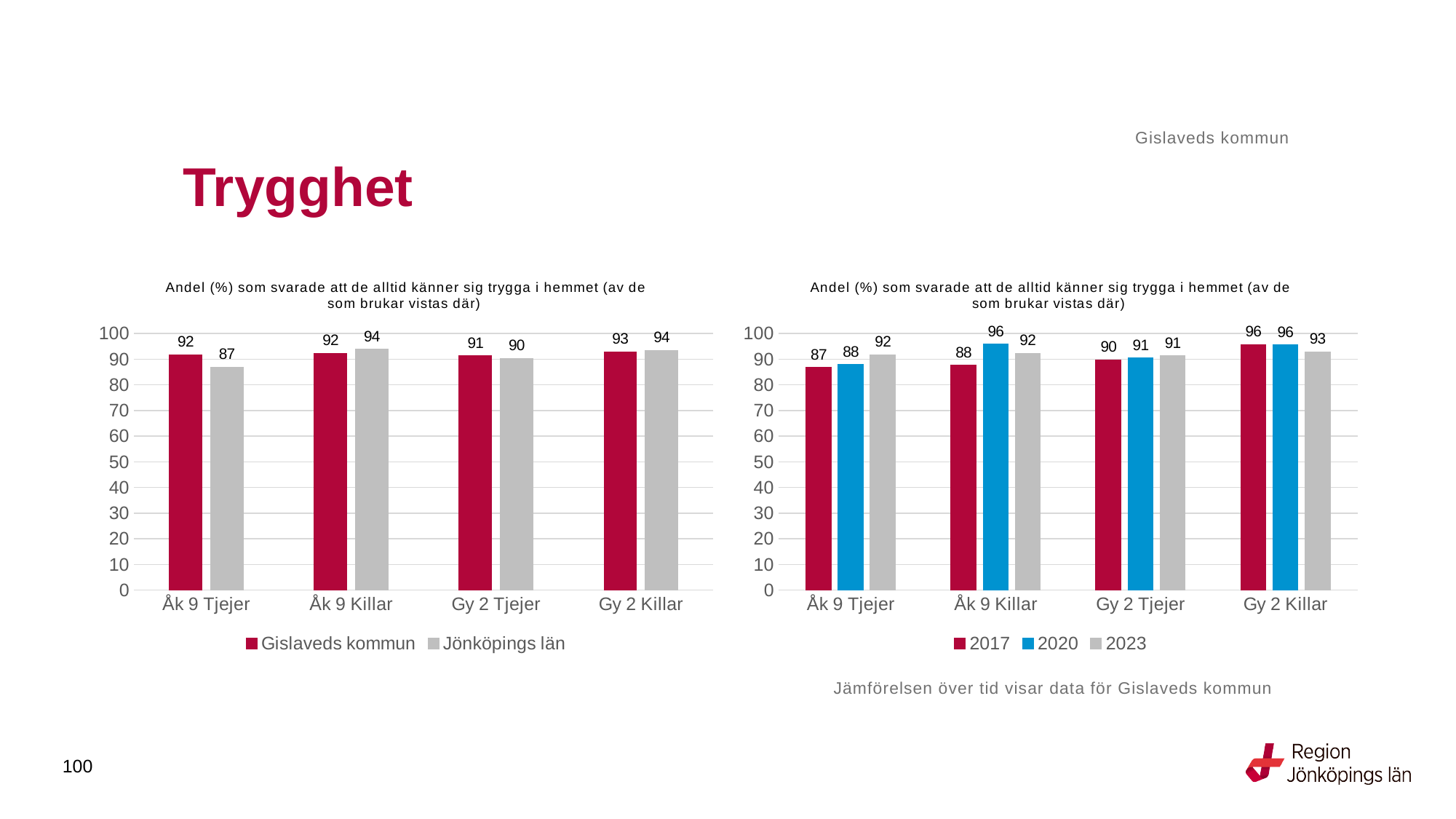
In the left chart, what is the value for Jönköpings län for Åk 9 Tjejer? 87 In the right chart, how many series does the legend list? 3 In the right chart, what is the value for 2020 for Åk 9 Killar? 96 In the left chart, which category has the lowest value for Jönköpings län? Åk 9 Tjejer In the right chart, what is the value for 2023 for Gy 2 Killar? 93 In the left chart, what is the difference between Gislaveds kommun and Jönköpings län for Åk 9 Tjejer? 5 In the right chart, which is larger for Åk 9 Killar: the 2020 value or the 2023 value? 2020 In the left chart, how many series does the legend list? 2 In the left chart, what is the value for Gislaveds kommun for Åk 9 Tjejer? 92 In the right chart, what is the difference between the 2023 and 2017 values for Åk 9 Tjejer? 5 In the right chart, which category has the lowest value for 2017? Åk 9 Tjejer What kind of chart is the right chart? Bar chart